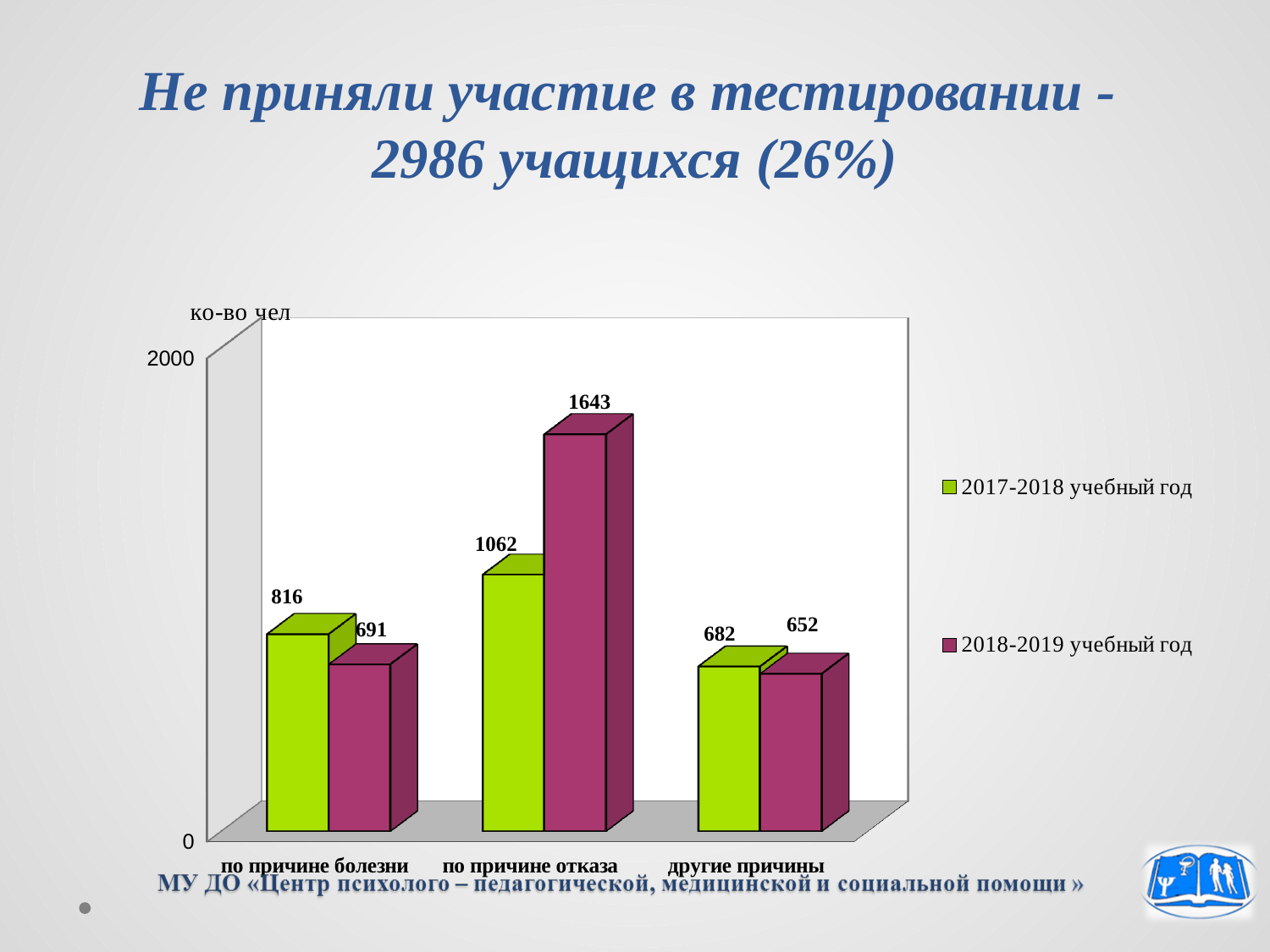
Which category has the highest value in the 2017-2018 учебный год series? по причине отказа How many series does the legend list? 2 Which category has the lowest value in the 2018-2019 учебный год series? другие причины How many categories are shown on the x axis? 3 What is the difference between the 2018-2019 and 2017-2018 values for "по причине отказа"? 581 What kind of chart is shown on the slide? bar chart What is the value for "другие причины" in the 2018-2019 учебный год series? 652 What is the value for "по причине отказа" in the 2018-2019 учебный год series? 1643 Is the value for "по причине отказа" in 2018-2019 учебный год greater or less than 2000? less What is the value for "по причине болезни" in the 2017-2018 учебный год series? 816 What is the label on the vertical axis of the chart? ко-во чел For "по причине болезни", which series has the larger value: 2017-2018 учебный год or 2018-2019 учебный год? 2017-2018 учебный год